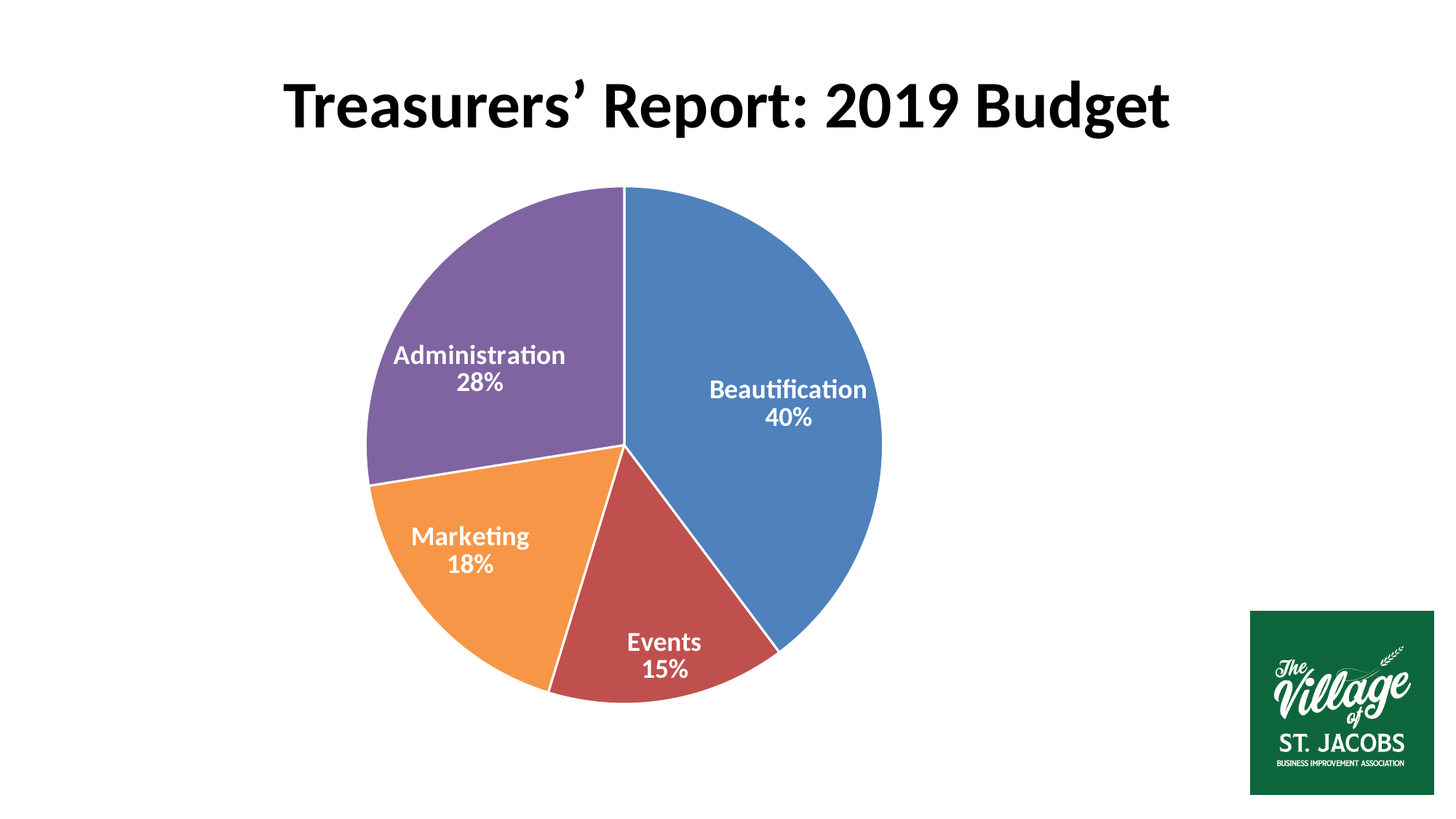
How many categories are shown in the pie chart? 4 What percentage of the 2019 budget is allocated to Events? 15% What percentage of the 2019 budget is allocated to Marketing? 18% What type of chart is shown on the slide? pie chart What is the difference in percentage points between Beautification and Administration? 12 What colour is the Beautification slice? blue Which category has the smallest share of the 2019 budget? Events What percentage of the 2019 budget is allocated to Administration? 28% What percentage of the 2019 budget is allocated to Beautification? 40% Which is larger, the share for Marketing or the share for Events? Marketing Which category has the largest share of the 2019 budget? Beautification What is the title of the chart on the slide? Treasurers' Report: 2019 Budget